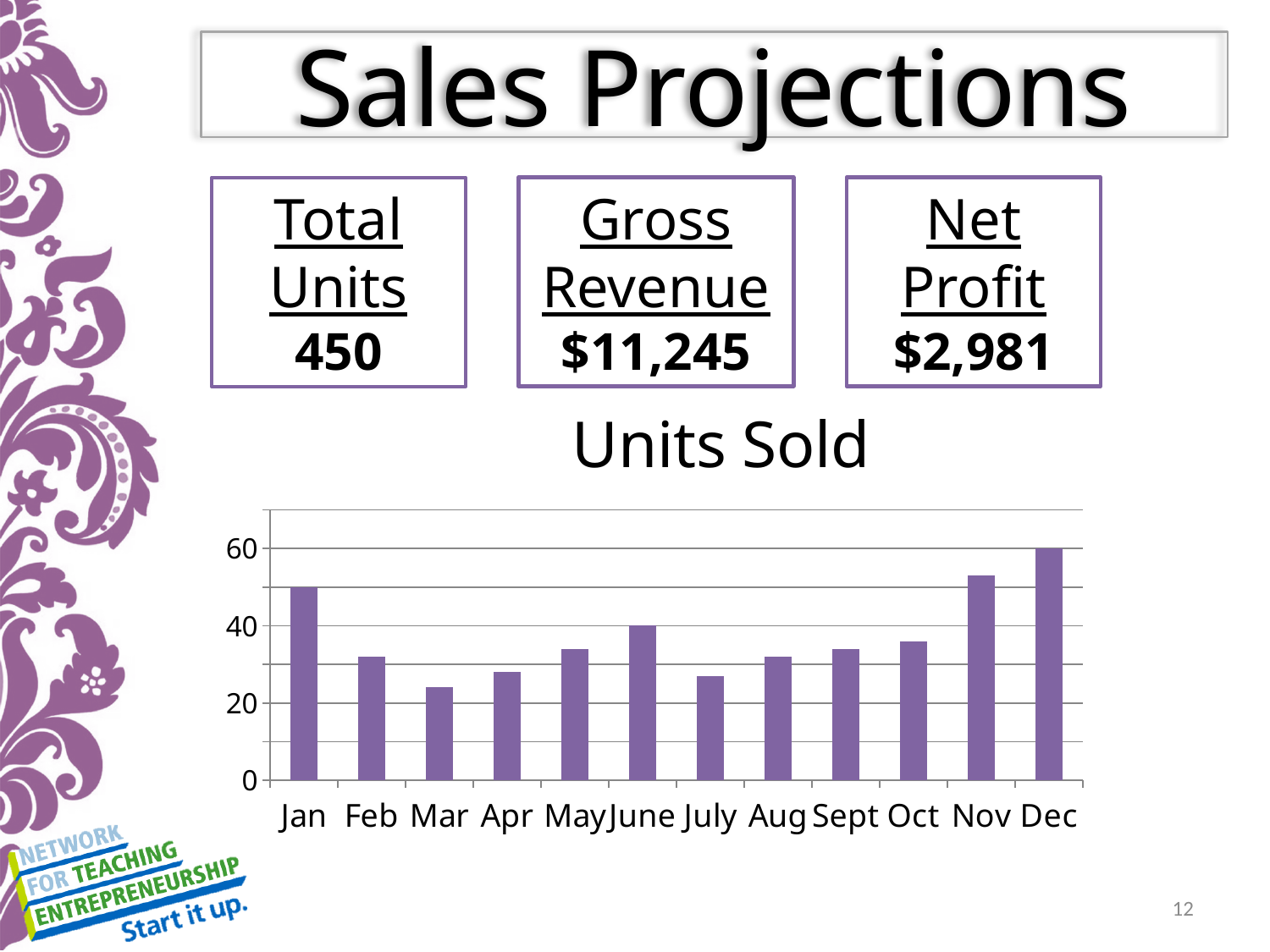
Which is larger, the value for Jan or the value for Apr? Jan What kind of chart is shown on the slide? bar chart Which month has the highest value in the Units Sold chart? Dec What is the value for Dec in the Units Sold chart? 60 Is the value for Nov greater or less than 40? greater Do the values rise or fall from Aug to Dec in the Units Sold chart? rise Which is larger, the value for Nov or the value for Feb? Nov How many months are shown on the x axis of the Units Sold chart? 12 Is the value for Mar greater or less than 40? less What is the title of the chart? Units Sold Is the value for Jan greater or less than 40? greater